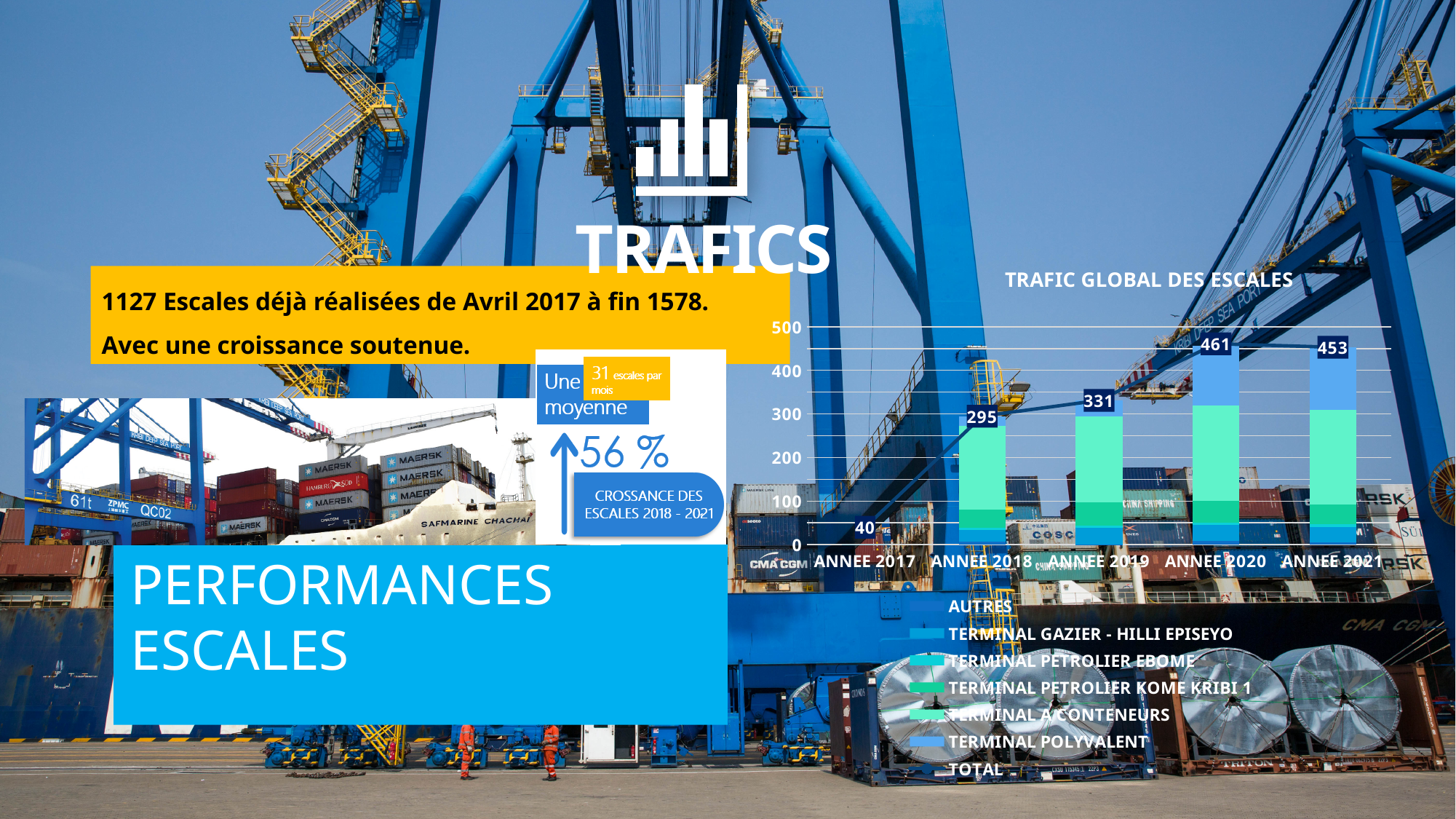
What is the title of the chart on the slide? TRAFIC GLOBAL DES ESCALES What type of chart is shown under the title TRAFIC GLOBAL DES ESCALES? bar chart What is the total value labelled for ANNEE 2018? 295 How many years are shown on the x axis of the chart? 5 What is the total value labelled for ANNEE 2020? 461 How many entries does the chart legend list? 7 What is the total value labelled for ANNEE 2019? 331 What is the total value labelled for ANNEE 2017? 40 What is the difference between the total for ANNEE 2020 and the total for ANNEE 2019? 130 Which year has the lowest total value in the chart? ANNEE 2017 Which year has the highest total value in the chart? ANNEE 2020 What is the total value labelled for ANNEE 2021? 453